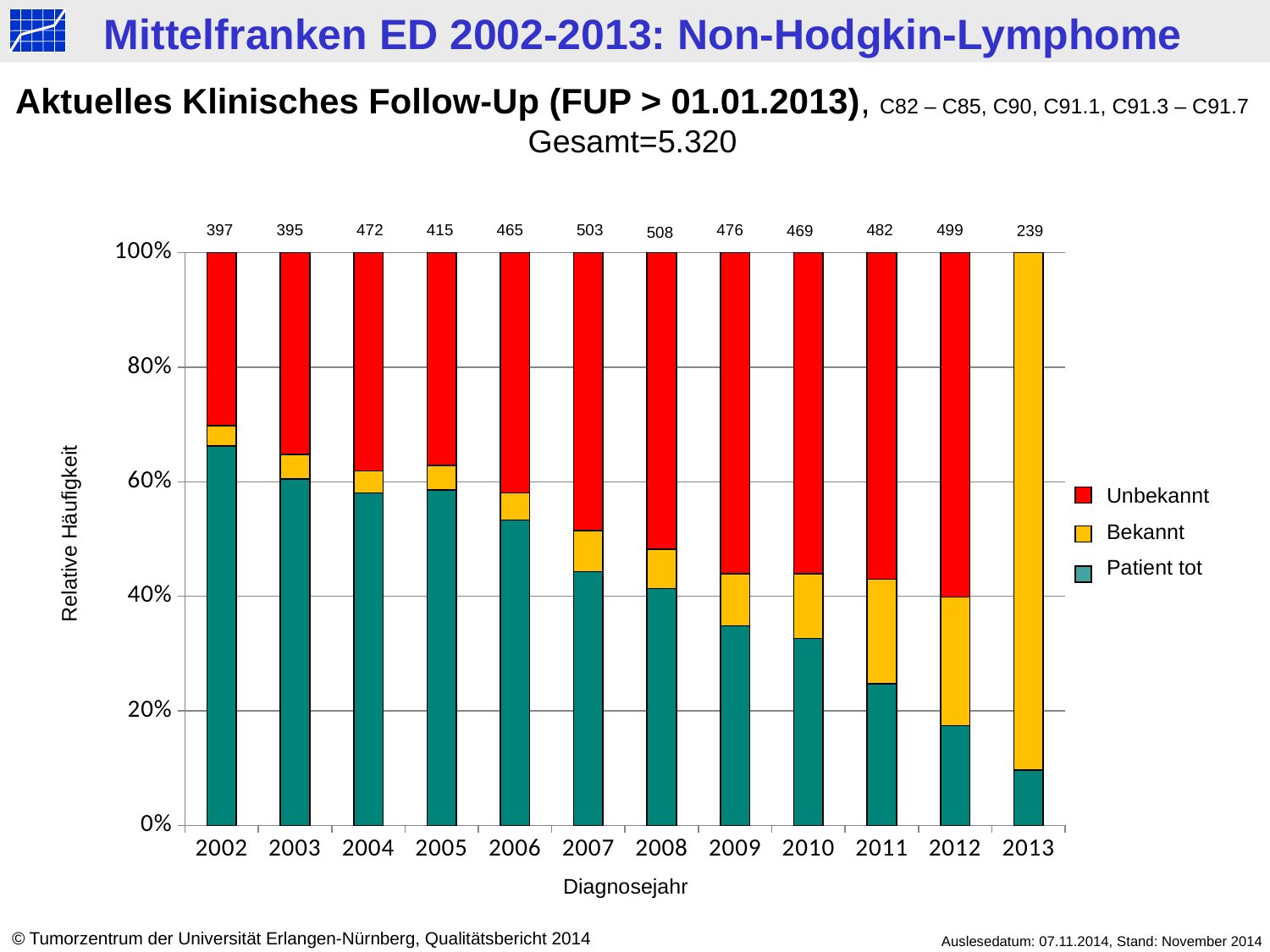
What number is printed above the bar for 2008? 508 Is the 'Patient tot' share for 2013 greater or less than 20%? less Is the 'Patient tot' share for 2002 greater or less than 60%? greater What number is printed above the bar for 2004? 472 Does the 'Patient tot' share rise or fall from 2002 to 2013? fall Which diagnosis year has the highest number printed above its bar? 2008 What is the difference between the numbers printed above the bars for 2008 and 2013? 269 What number is printed above the bar for 2013? 239 Which year has the larger number printed above its bar, 2004 or 2005? 2004 Which diagnosis year has the lowest number printed above its bar? 2013 How many diagnosis years are shown on the x axis? 12 How many series does the legend list? 3